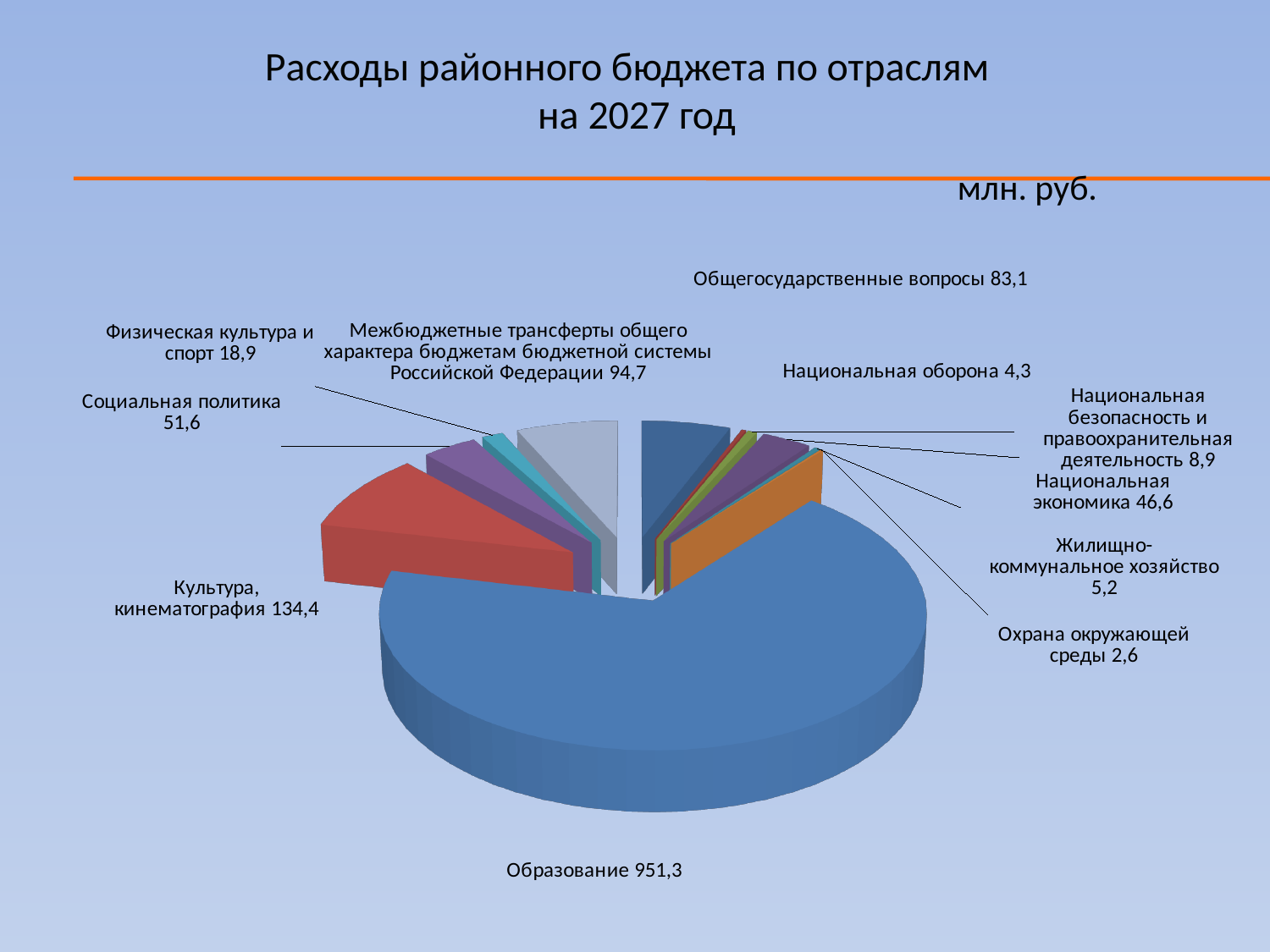
What unit is indicated for the values on the slide? млн. руб. What is the difference between Культура, кинематография and Межбюджетные трансферты общего характера бюджетам бюджетной системы Российской Федерации? 39,7 What is the value for Образование? 951,3 Which category has the smallest value? Охрана окружающей среды What is the value for Национальная экономика? 46,6 How many categories are shown in the pie chart? 11 What type of chart is shown on the slide? Pie chart What is the value for Культура, кинематография? 134,4 What is the value for Охрана окружающей среды? 2,6 Which category has the largest value? Образование Which is larger: Национальная оборона or Жилищно-коммунальное хозяйство? Жилищно-коммунальное хозяйство What is the difference between Общегосударственные вопросы and Социальная политика? 31,5